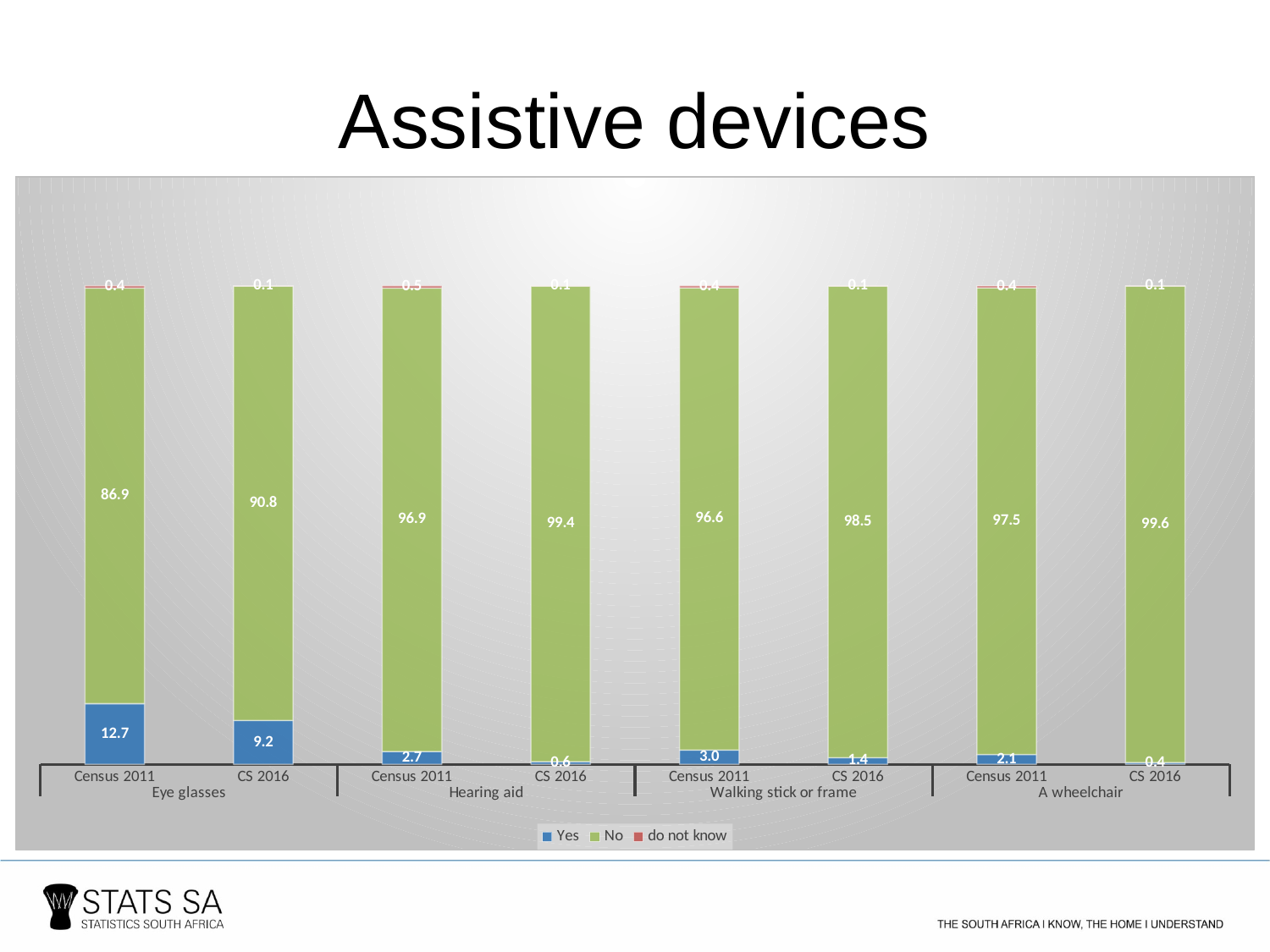
What is the 'Yes' value for A wheelchair in CS 2016? 0.4 What is the total of the stacked bar for Walking stick or frame in CS 2016? 100.0 Which is larger: the 'Yes' value for Walking stick or frame in Census 2011 or for Hearing aid in Census 2011? Walking stick or frame, Census 2011 What is the 'do not know' value for Hearing aid in Census 2011? 0.5 What is the 'No' value for Hearing aid in CS 2016? 99.4 Which bar has the highest 'No' value? A wheelchair, CS 2016 How many stacked bars are shown in the chart? 8 What is the 'Yes' value for Eye glasses in Census 2011? 12.7 What is the difference between the 'Yes' values for Eye glasses in Census 2011 and CS 2016? 3.5 How many series does the legend list? 3 Which bar has the highest 'Yes' value? Eye glasses, Census 2011 What kind of chart is shown on the slide? Stacked bar chart